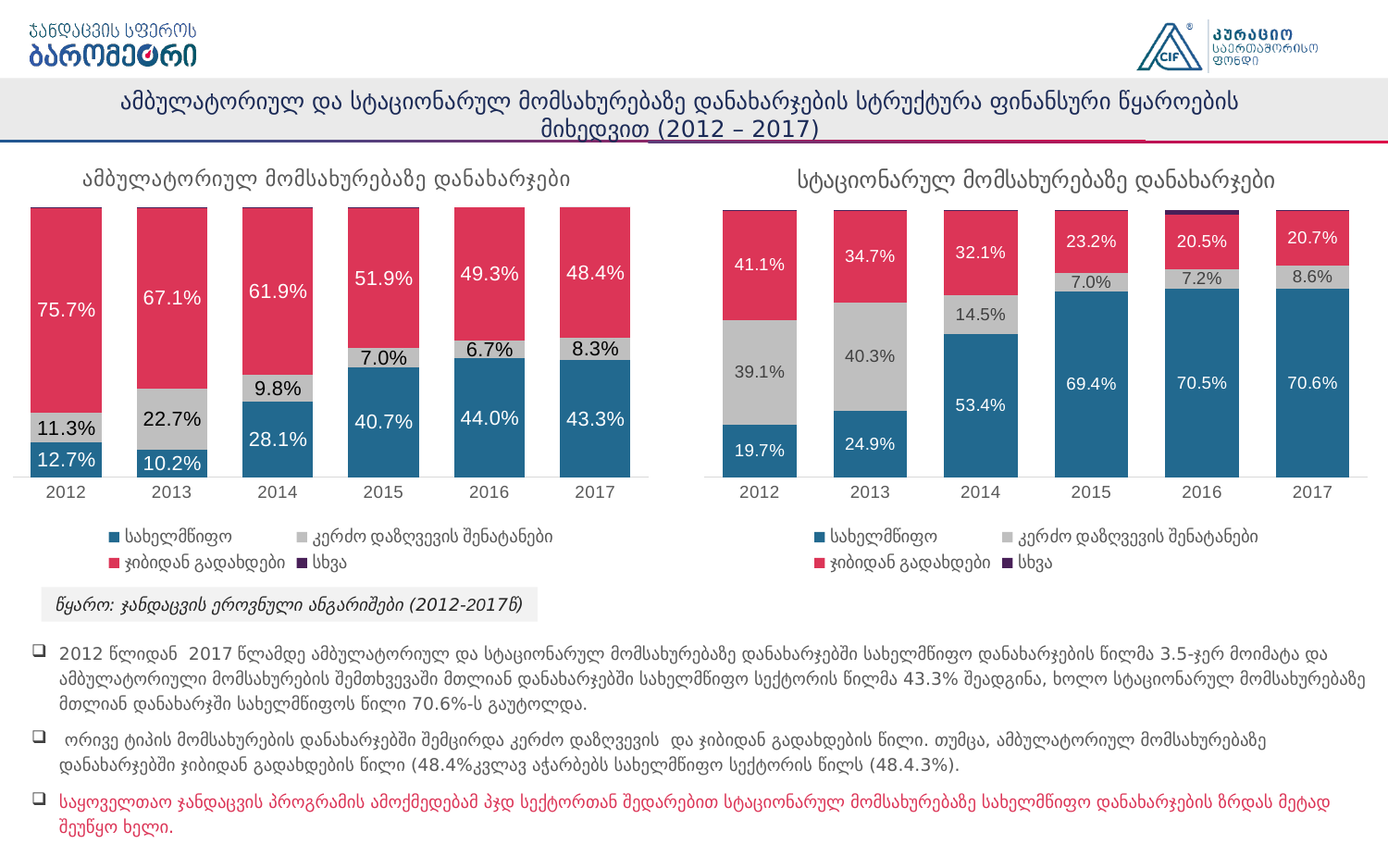
How many years are shown on the x axis of the left chart? 6 In the right chart, what is the value of the სახელმწიფო series for 2014? 53.4% In the left chart, which year has the highest value for the ჯიბიდან გადახდები series? 2012 In the right chart, which is larger for 2013: the სახელმწიფო value or the ჯიბიდან გადახდები value? ჯიბიდან გადახდები In the right chart (სტაციონარულ მომსახურებაზე დანახარჯები), what is the value of the ჯიბიდან გადახდები series for 2012? 41.1% In the right chart, does the სახელმწიფო series rise or fall from 2012 to 2017? Rise How many series does the legend of the right chart list? 4 In the left chart, what is the value of the კერძო დაზღვევის შენატანები series for 2013? 22.7% In the left chart (ამბულატორიულ მომსახურებაზე დანახარჯები), what is the value of the სახელმწიფო series for 2017? 43.3% In the left chart, what is the difference between the სახელმწიფო values for 2016 and 2012? 31.3% What type of chart is the right chart? Stacked bar chart In the right chart, which year has the lowest value for the სახელმწიფო series? 2012